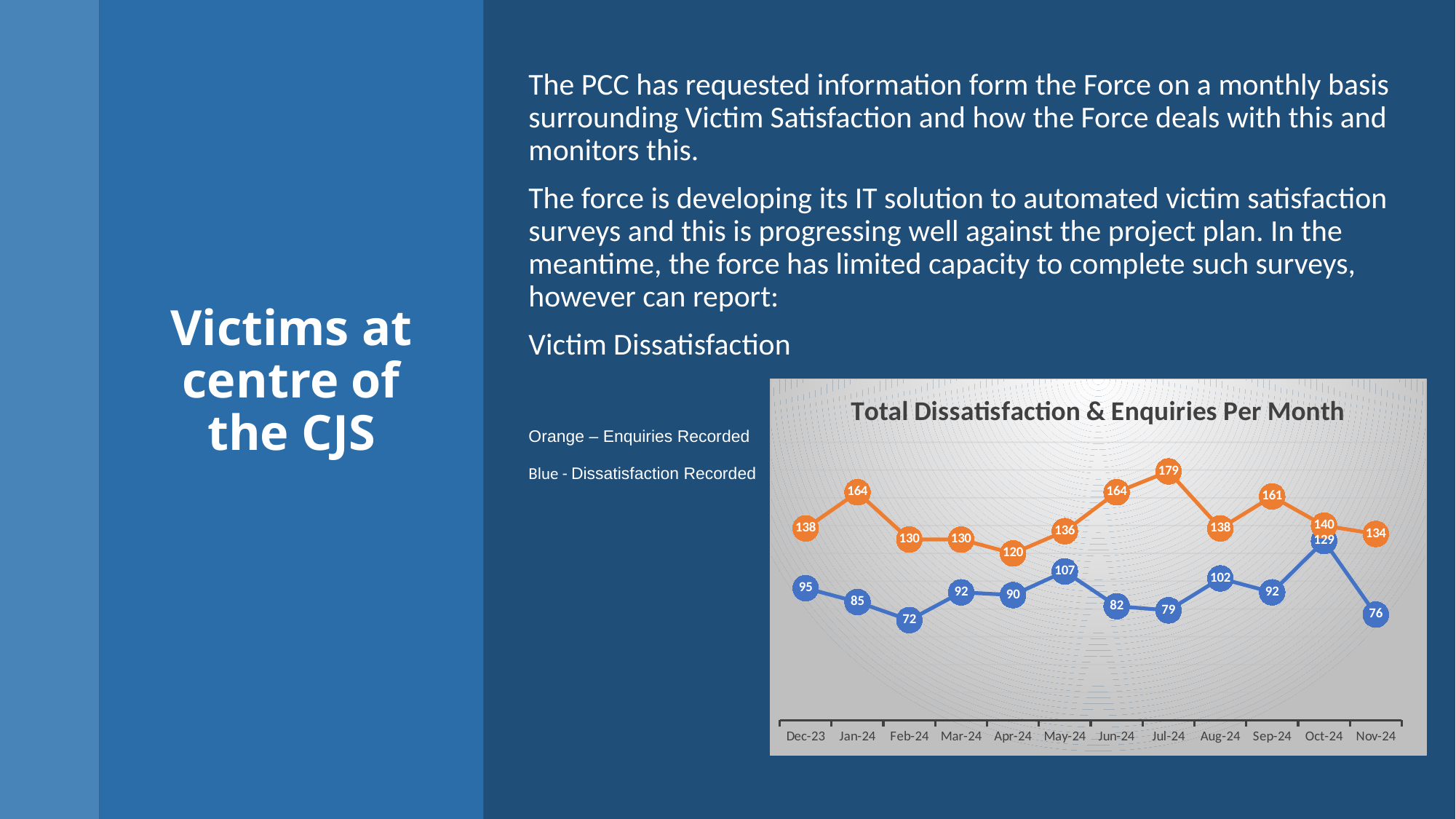
What is the difference between Enquiries Recorded and Dissatisfaction Recorded in Nov-24? 58 What is the value of Enquiries Recorded (orange line) for Apr-24? 120 What kind of chart is shown on the slide? line chart What is the value of Dissatisfaction Recorded (blue line) for Oct-24? 129 How many data series are plotted in the chart? 2 In which month is Enquiries Recorded (orange line) highest? Jul-24 Does Dissatisfaction Recorded (blue line) rise or fall from Oct-24 to Nov-24? fall What is the title of the chart? Total Dissatisfaction & Enquiries Per Month What is the value of Enquiries Recorded (orange line) for Jul-24? 179 How many months are plotted along the x axis of the chart? 12 Which is larger: Dissatisfaction Recorded in May-24 or in Jun-24? May-24 In which month is Dissatisfaction Recorded (blue line) lowest? Feb-24